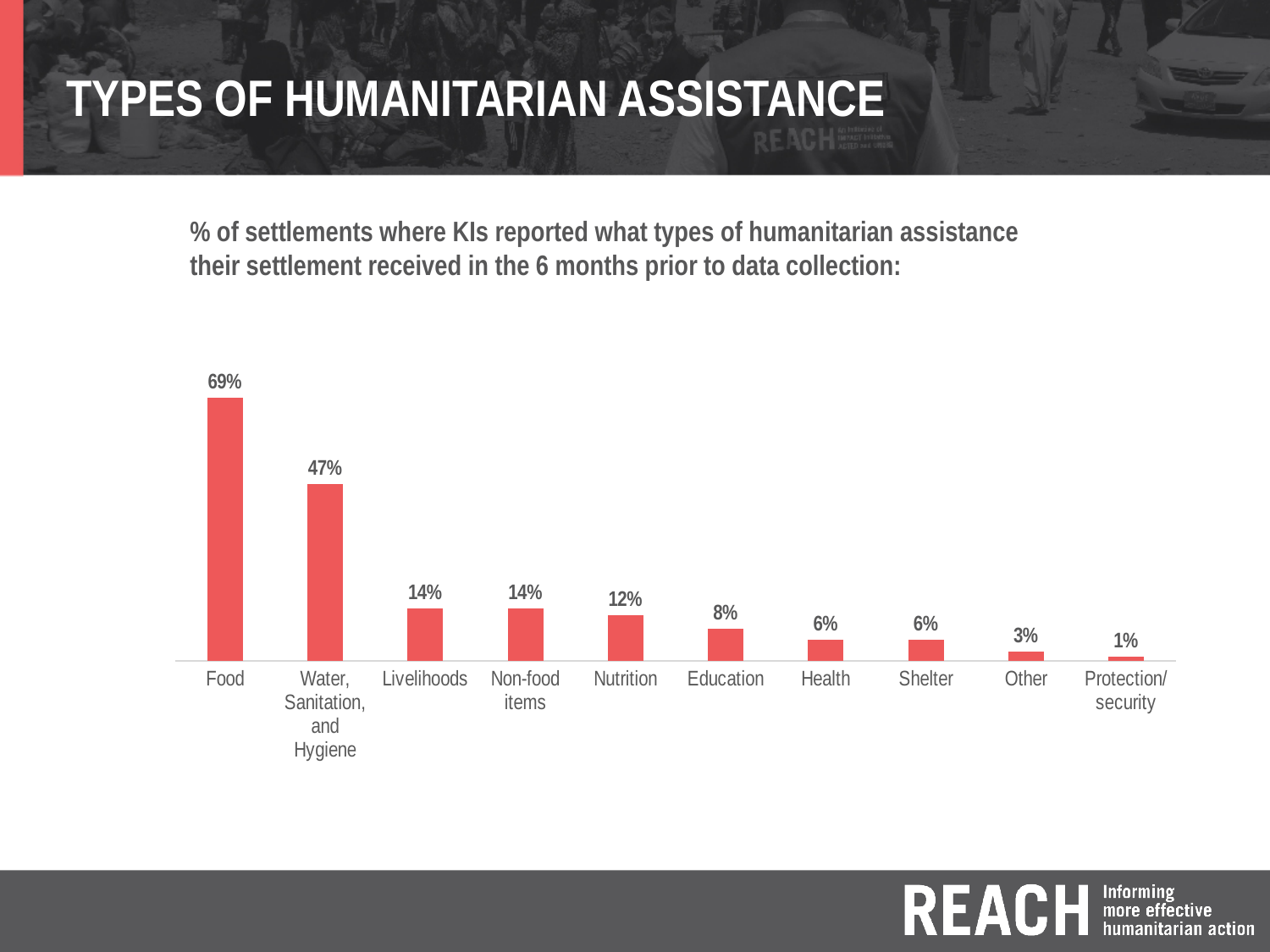
What is the value shown for Water, Sanitation, and Hygiene? 47% Which type of humanitarian assistance has the highest percentage? Food Which is larger, the value for Nutrition or the value for Education? Nutrition What is the difference between the values for Food and Water, Sanitation, and Hygiene? 22% What percentage of settlements reported receiving Food assistance? 69% What is the difference between the values for Education and Other? 5% What kind of chart is shown on the slide? Bar chart Do the values rise or fall from left to right across the categories? Fall What is the value for Protection/security? 1% How many types of humanitarian assistance are shown on the chart? 10 Which type of humanitarian assistance has the lowest percentage? Protection/security What percentage is shown for Nutrition? 12%